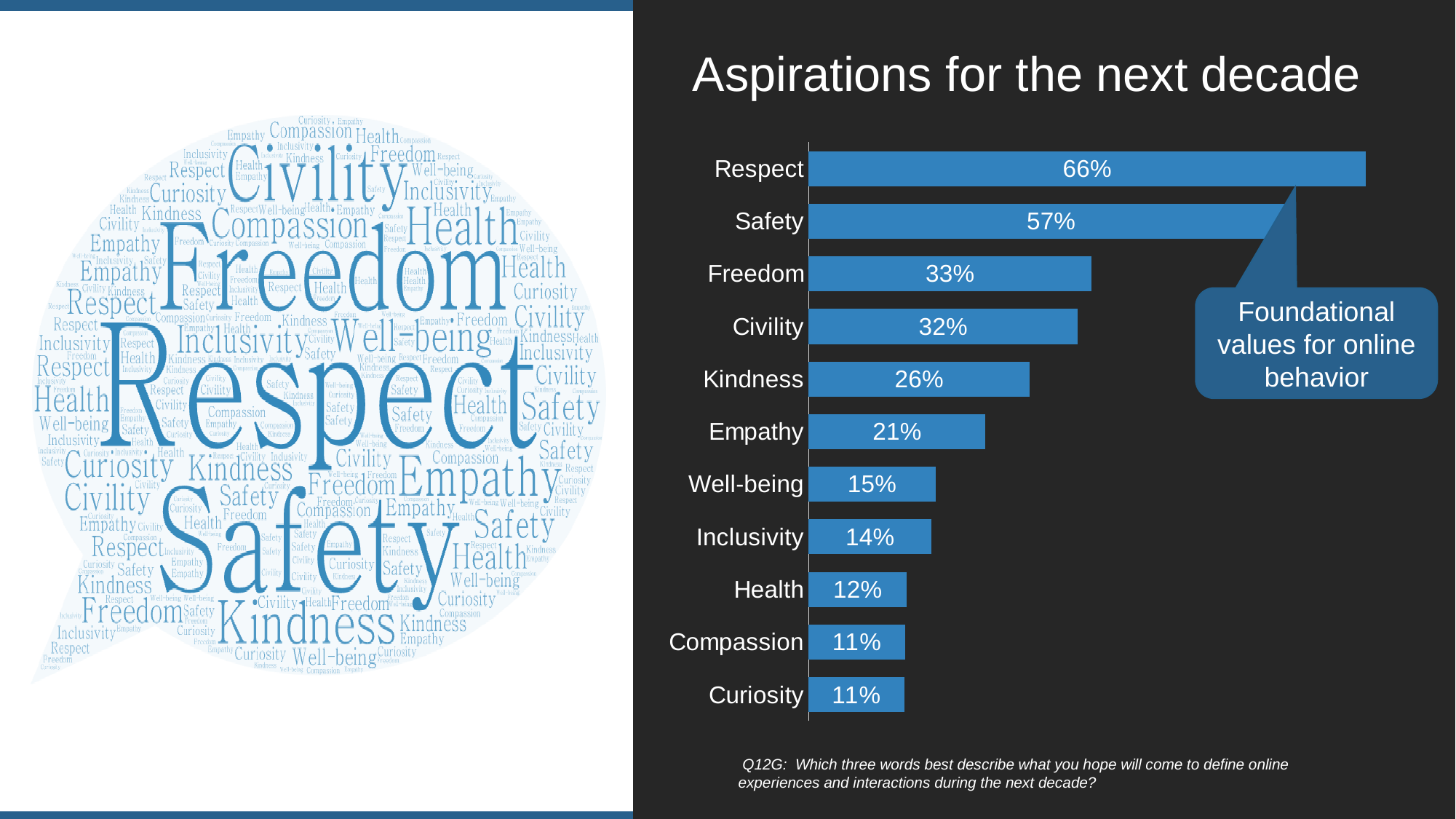
What does the callout box on the chart say? Foundational values for online behavior What is the difference between the values for Freedom and Empathy? 12% Which is larger, the value for Safety or the value for Freedom? Safety What percentage is shown for Respect? 66% What kind of chart is shown on the slide? Bar chart What percentage is shown for Inclusivity? 14% Which category has the highest value? Respect How many categories are shown in the chart? 11 What is the difference between the values for Respect and Safety? 9% What is the title of the chart? Aspirations for the next decade What percentage is shown for Kindness? 26% Which is larger, the value for Civility or the value for Well-being? Civility